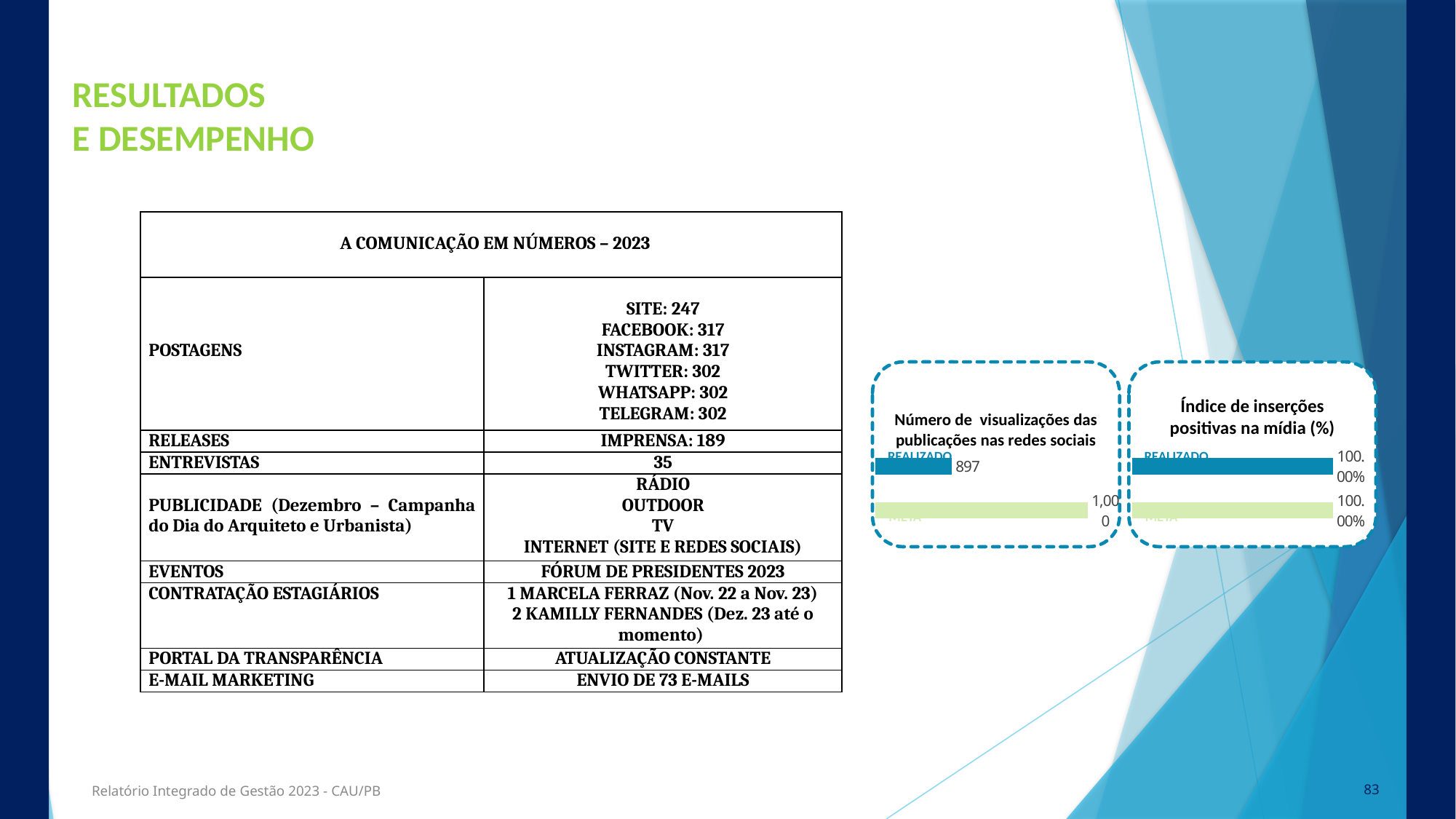
How many bars are shown in the chart titled "Número de visualizações das publicações nas redes sociais"? 2 In the chart titled "Número de visualizações das publicações nas redes sociais", which category has the highest value? META In the chart titled "Número de visualizações das publicações nas redes sociais", what is the value for REALIZADO? 897 In the chart titled "Índice de inserções positivas na mídia (%)", what is the value for META? 100.00% What is the title of the chart on the far right of the slide? Índice de inserções positivas na mídia (%) In the chart titled "Número de visualizações das publicações nas redes sociais", what is the value for META? 1,000 In the chart titled "Índice de inserções positivas na mídia (%)", what is the value for REALIZADO? 100.00% In the chart titled "Número de visualizações das publicações nas redes sociais", what is the difference between META and REALIZADO? 103 What kind of chart is the one titled "Índice de inserções positivas na mídia (%)"? Bar chart In the chart titled "Número de visualizações das publicações nas redes sociais", which bar is larger, REALIZADO or META? META How many charts are shown on the slide? 2